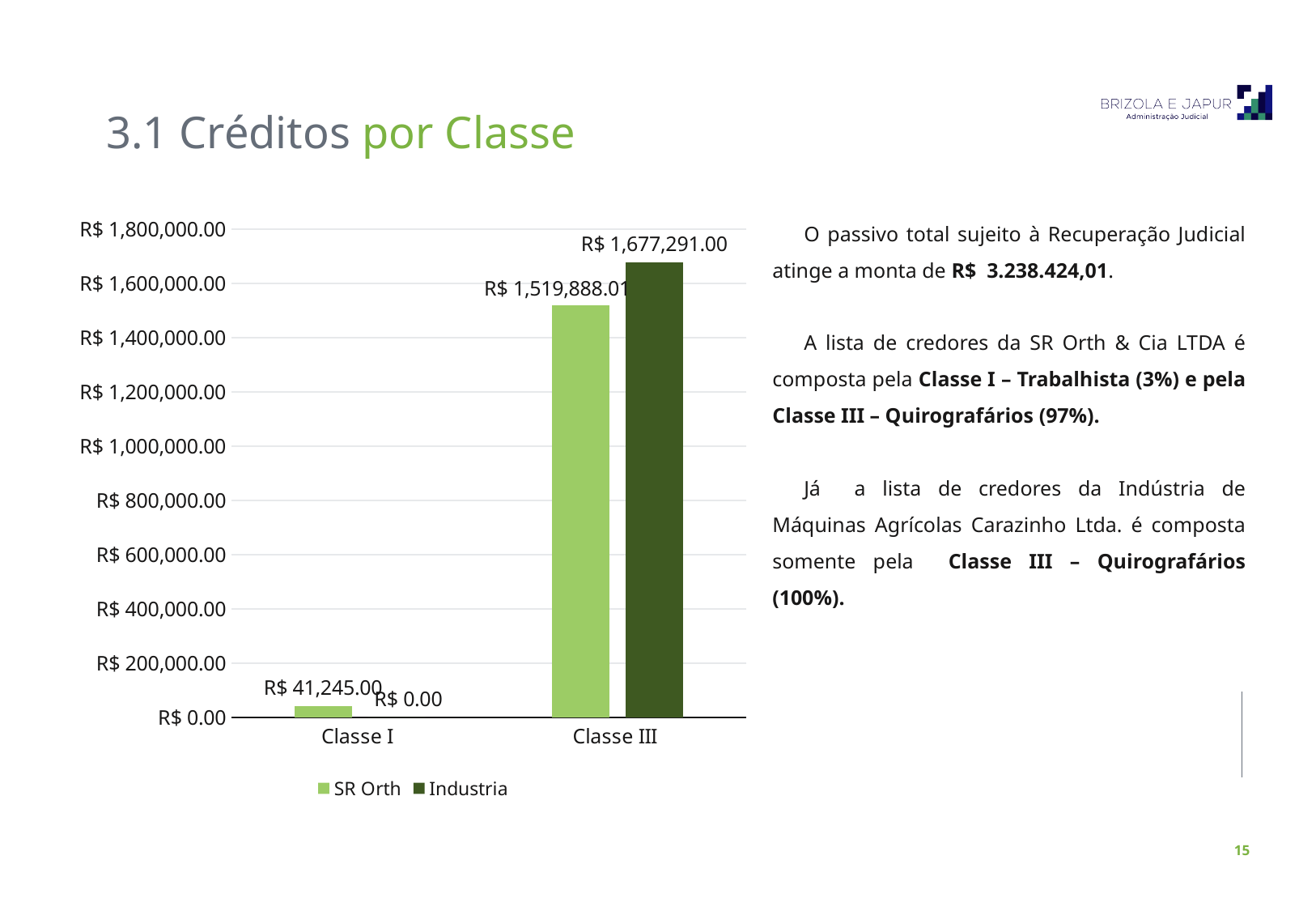
What kind of chart is shown on the slide? Bar chart How many categories are shown on the x axis? 2 What is the value for Industria in Classe III? R$ 1,677,291.00 What is the value for SR Orth in Classe III? R$ 1,519,888.01 What is the difference between the Industria and SR Orth values in Classe III? R$ 157,402.99 What is the difference between the SR Orth values for Classe III and Classe I? R$ 1,478,643.01 What is the value for Industria in Classe I? R$ 0.00 What is the value for SR Orth in Classe I? R$ 41,245.00 How many series does the legend list? 2 Which bar has the lowest value on the chart? Industria in Classe I Which series has the highest value in Classe III? Industria Which is larger: SR Orth in Classe III or Industria in Classe III? Industria in Classe III